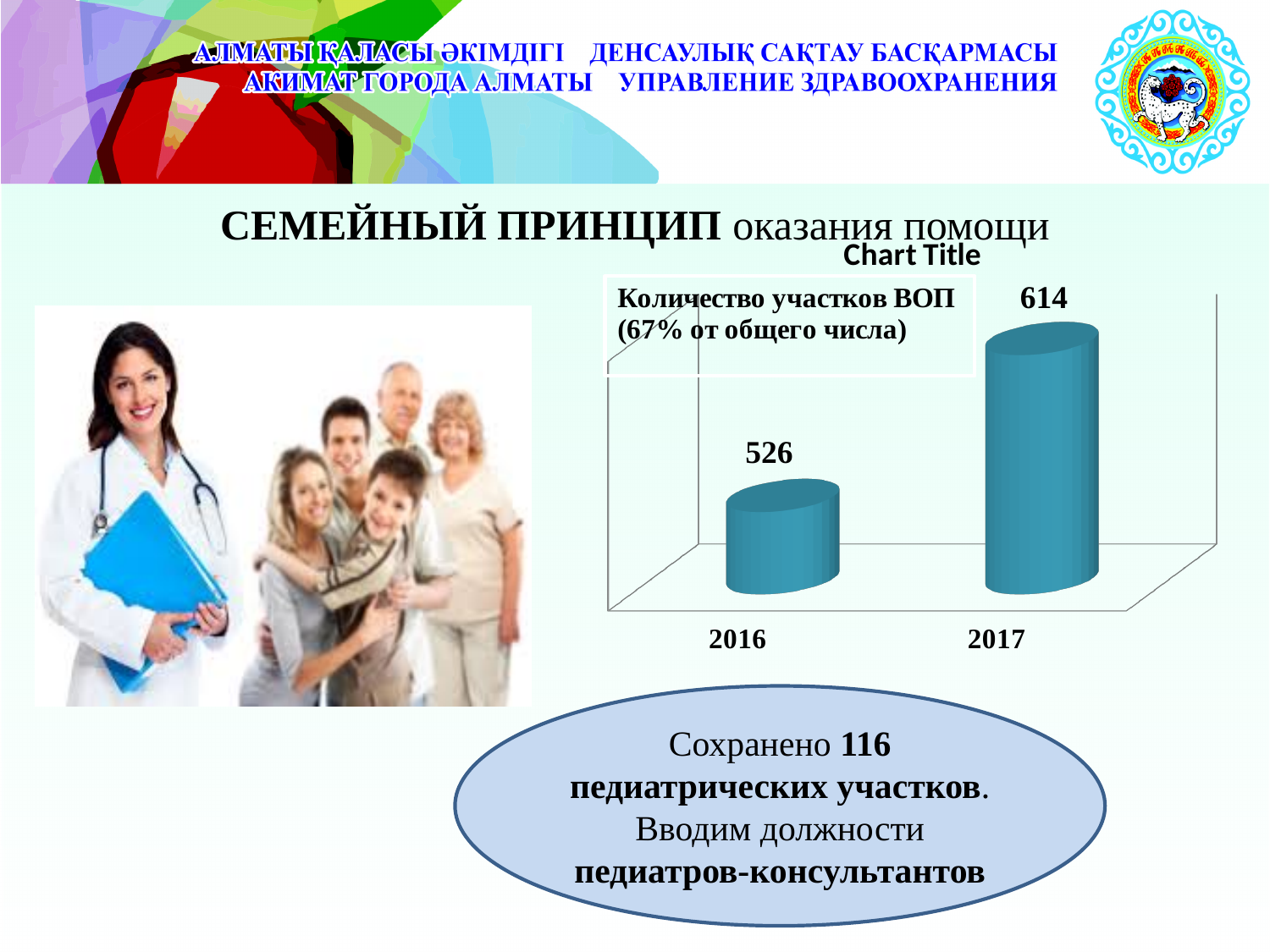
Which is larger, the value for 2016 or the value for 2017? 2017 Do the values rise or fall from 2016 to 2017? rise Which year has the highest value? 2017 What does the text box on the chart say the bars represent? Количество участков ВОП (67% от общего числа) What is the difference between the values for 2017 and 2016? 88 What is the value for 2017? 614 What is the title shown above the chart? Chart Title How many categories are shown on the chart? 2 Which year has the lowest value? 2016 What kind of chart is shown on the slide? bar chart What is the value for 2016? 526